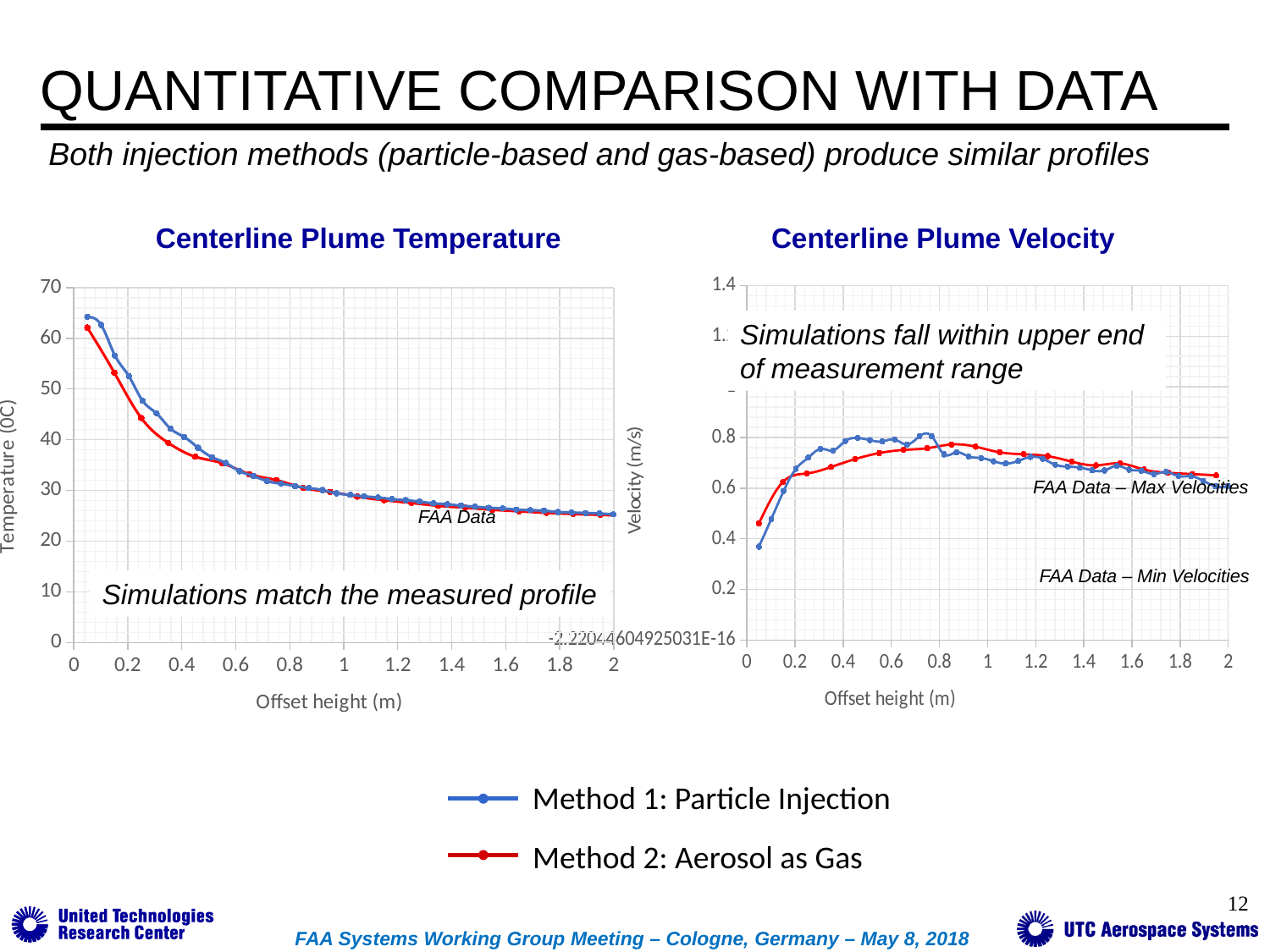
In the Centerline Plume Temperature chart, is the Method 1: Particle Injection value at offset height 1 m greater or less than 20? greater How many series does the legend list for the charts? 2 Which colour is used for the Method 2: Aerosol as Gas series? red In the Centerline Plume Velocity chart, is the Method 1: Particle Injection value at the smallest offset height greater or less than 0.4? less In the Centerline Plume Temperature chart, do the temperature values rise or fall as offset height increases? fall In the Centerline Plume Velocity chart, is the Method 2: Aerosol as Gas value at offset height 1 m greater or less than 0.6? greater In the Centerline Plume Velocity chart, which series reaches the higher peak velocity? Method 1: Particle Injection What is the x-axis label of the Centerline Plume Velocity chart? Offset height (m) What kind of chart is the Centerline Plume Temperature chart? line chart In the Centerline Plume Velocity chart, which series has the larger value at the smallest offset height, Method 1: Particle Injection or Method 2: Aerosol as Gas? Method 2: Aerosol as Gas